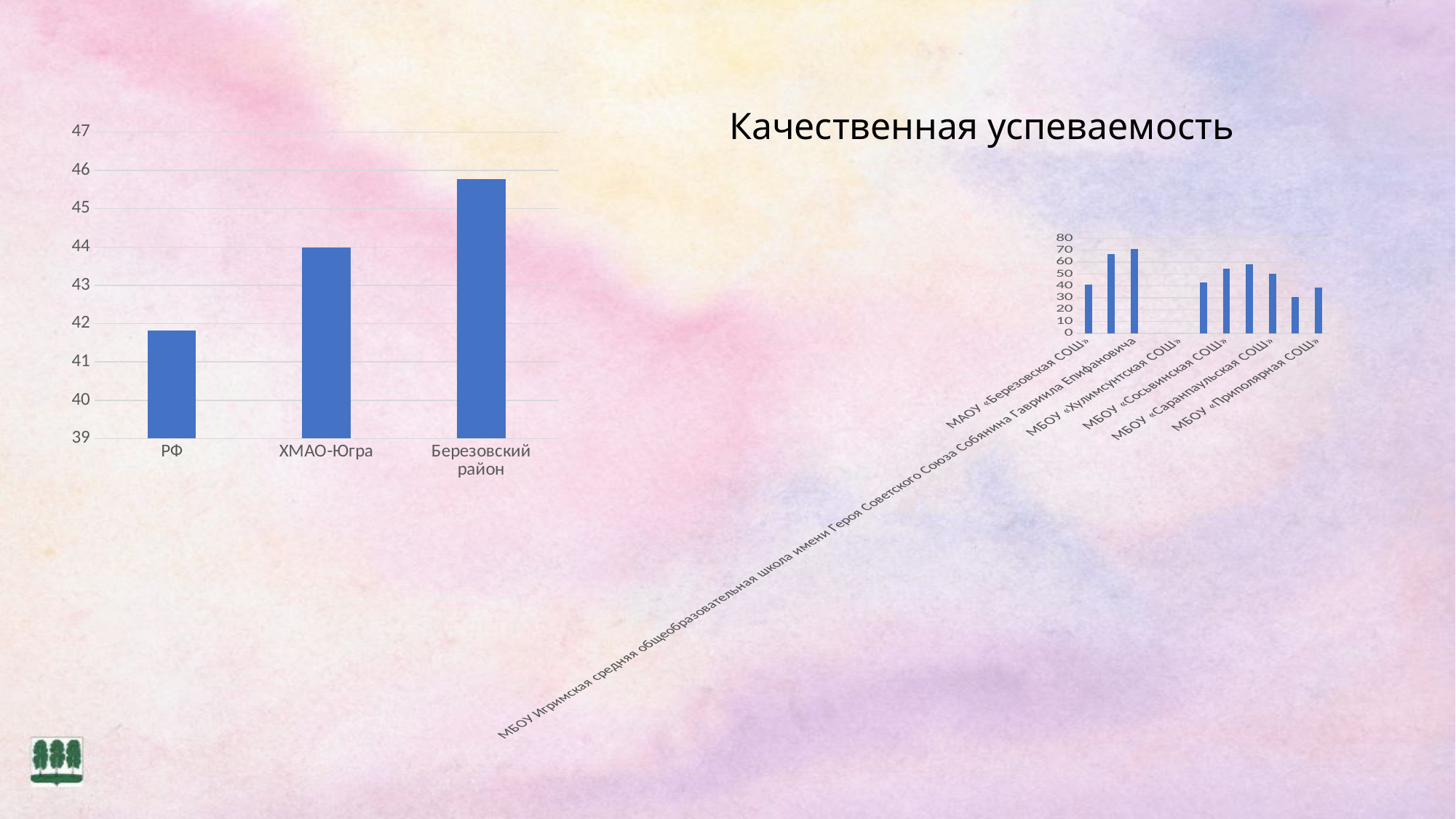
What kind of chart is the chart on the right of the slide? bar chart In the chart on the left of the slide, which is larger, the value for РФ or the value for ХМАО-Югра? ХМАО-Югра In the chart on the left of the slide, is the value for РФ greater or less than 42? less In the chart on the left of the slide, which category has the lowest value? РФ How many categories does the chart on the left of the slide show? 3 In the chart on the left of the slide, is the value for Березовский район greater or less than 45? greater What is the highest value shown on the vertical axis of the chart on the right of the slide? 80 In the chart on the left of the slide, do the values rise or fall from РФ to Березовский район? rise What is the title shown above the chart on the right of the slide? Качественная успеваемость What kind of chart is the chart on the left of the slide? bar chart In the chart on the left of the slide, which category has the highest value? Березовский район